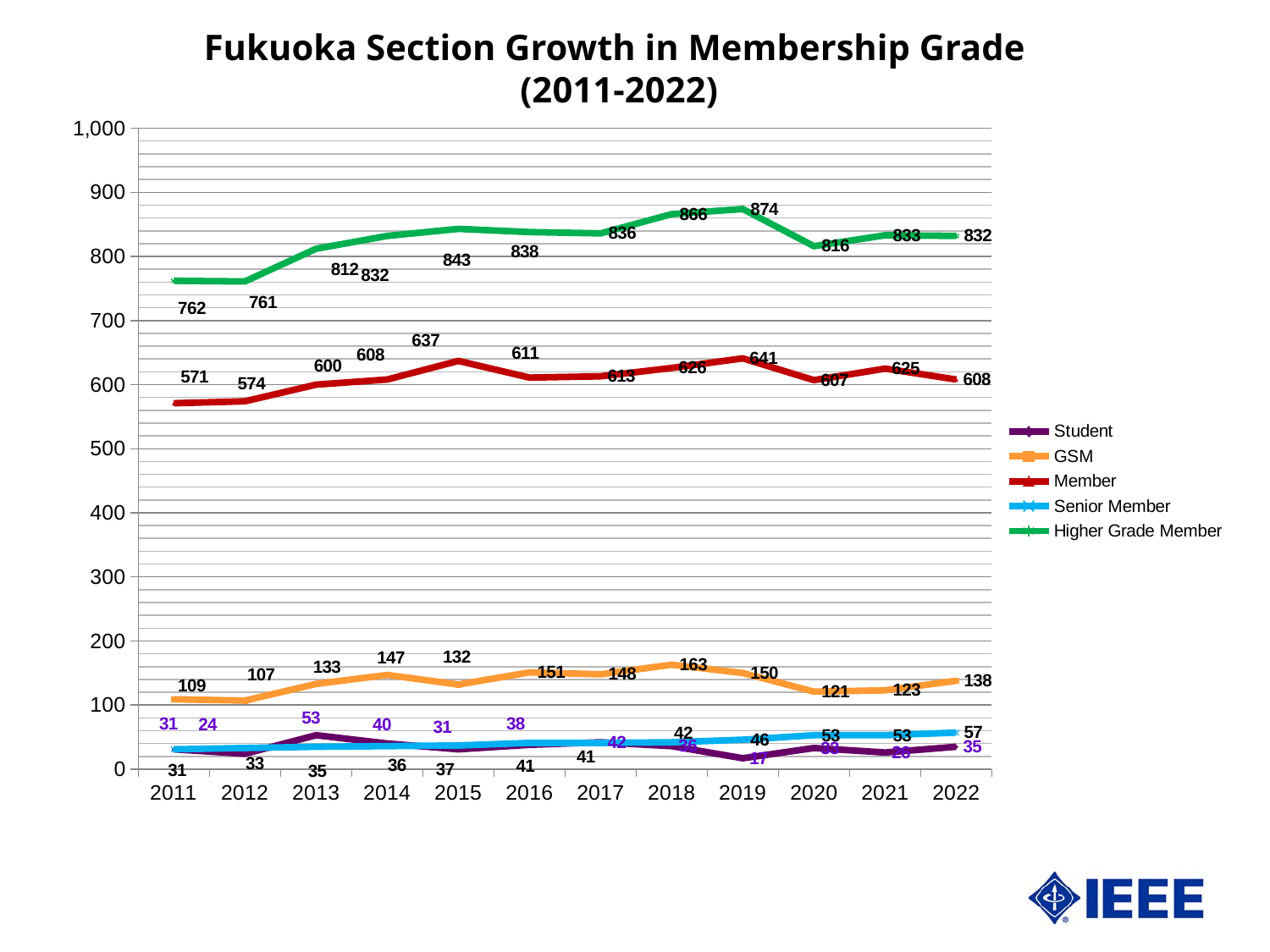
Which is larger, the Member value in 2015 or in 2016? 2015 What is the value for GSM in 2018? 163 What is the value for Senior Member in 2022? 57 What kind of chart is shown on the slide? line chart What is the title of the chart? Fukuoka Section Growth in Membership Grade (2011-2022) In which year is the Higher Grade Member value highest? 2019 How many years are shown on the x axis? 12 In which year is the GSM value lowest? 2012 What is the difference between the Higher Grade Member values in 2022 and 2011? 70 How many series does the legend list? 5 What is the value for Higher Grade Member in 2019? 874 What is the value for Member in 2015? 637